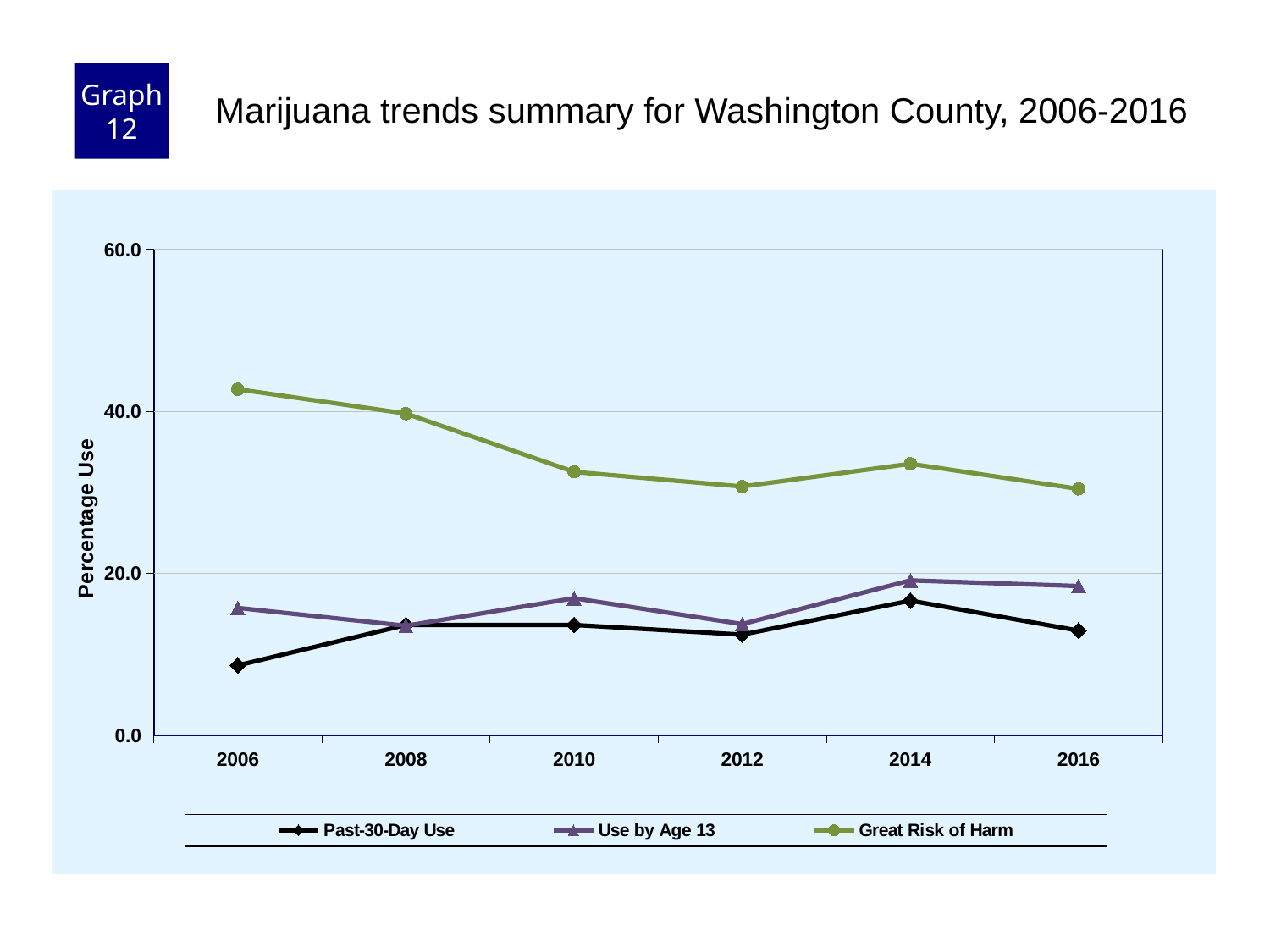
Does Great Risk of Harm rise or fall overall from 2006 to 2016? fall What is the label on the y axis? Percentage Use Is the value for Past-30-Day Use in 2014 greater or less than 20? less In 2006, which is larger: Past-30-Day Use or Use by Age 13? Use by Age 13 In which year is Great Risk of Harm highest? 2006 In which year is Past-30-Day Use lowest? 2006 In which year is Past-30-Day Use highest? 2014 What kind of chart is shown on the slide? line chart Is the value for Great Risk of Harm in 2006 greater or less than 40? greater How many series does the legend list? 3 Is the value for Great Risk of Harm in 2012 greater or less than 40? less How many years are plotted along the x axis? 6